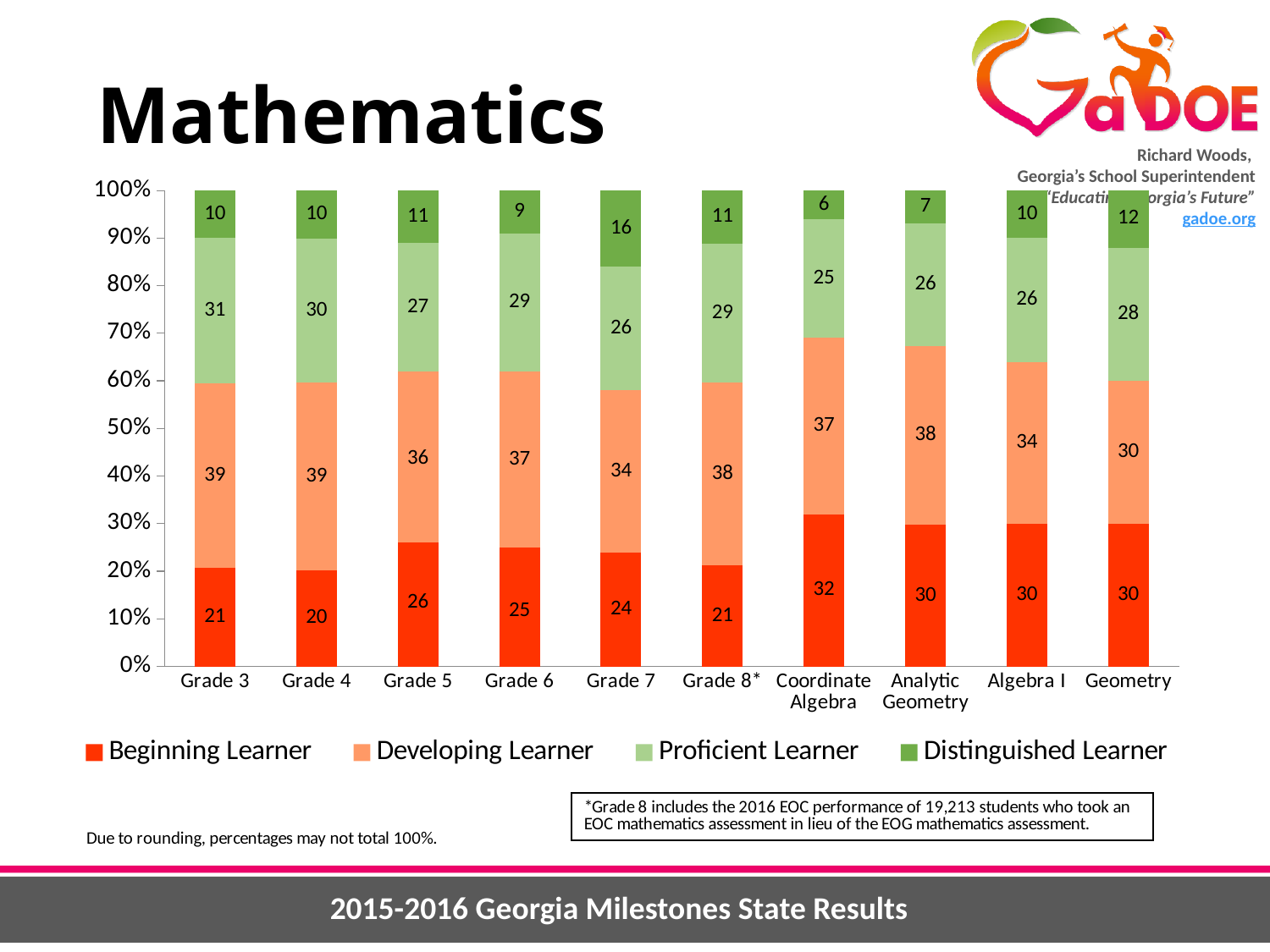
Which category has the lowest Distinguished Learner percentage? Coordinate Algebra What is the Distinguished Learner value for Grade 7? 16 Which is larger, the Developing Learner value for Grade 5 or for Geometry? Grade 5 What kind of chart is shown on the slide? Stacked bar chart Which category has the highest Distinguished Learner percentage? Grade 7 Which category has the highest Beginning Learner percentage? Coordinate Algebra What is the Developing Learner value for Analytic Geometry? 38 How many series does the legend list? 4 What is the sum of the four printed values for Grade 5? 100 What percentage of Grade 3 students are Beginning Learners? 21 How many categories are shown on the x axis? 10 What is the difference between the Proficient Learner values for Grade 3 and Grade 5? 4